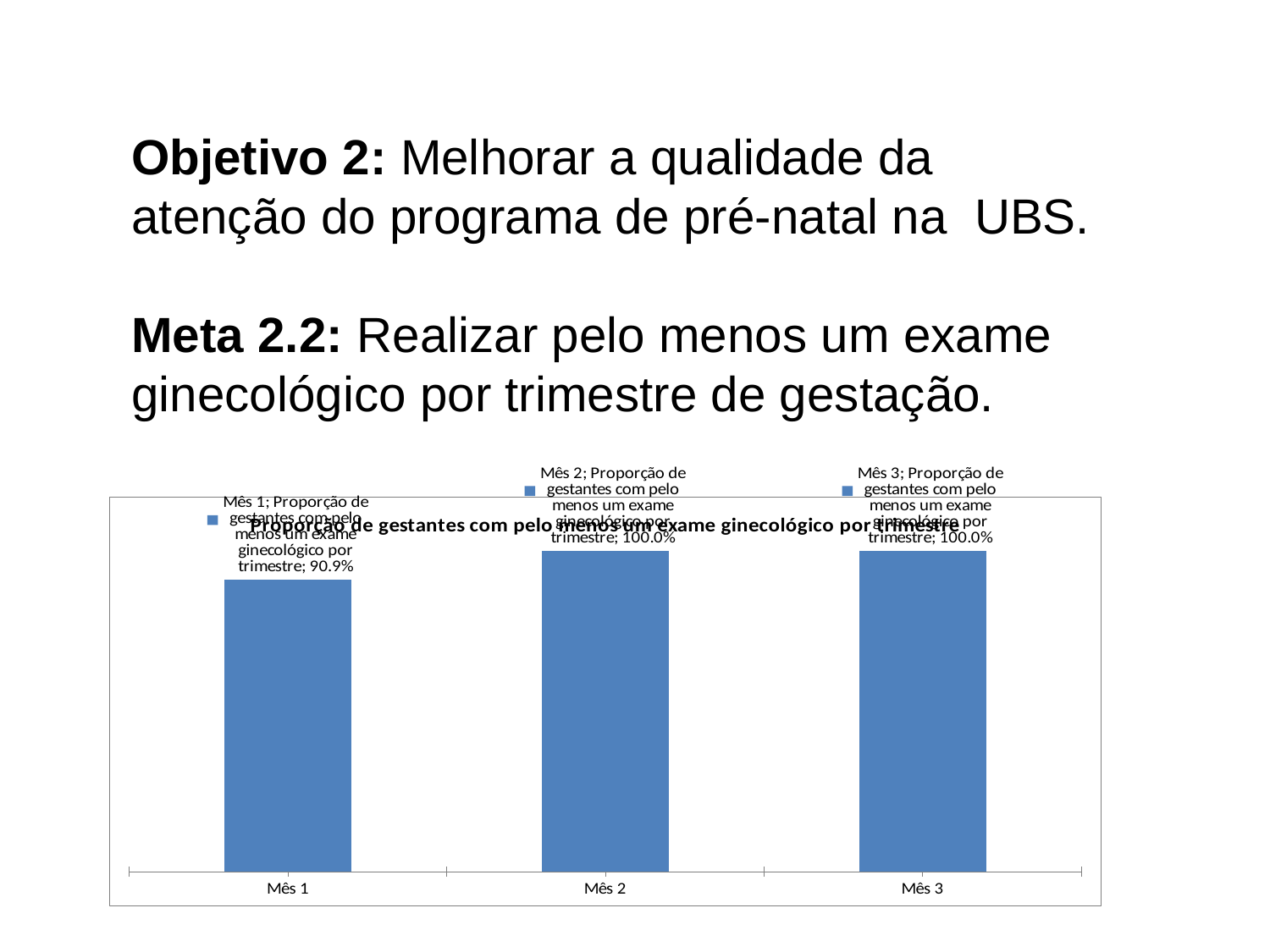
What colour are the bars in the chart? Blue How many months are shown on the x axis? 3 What is the difference between the values for Mês 2 and Mês 1? 9.1% What is the value for Mês 2? 100.0% Which month has the lowest value? Mês 1 What is the title of the chart? Proporção de gestantes com pelo menos um exame ginecológico por trimestre What kind of chart is shown on the slide? Bar chart What is the value for Mês 1? 90.9% Which is larger, the value for Mês 1 or the value for Mês 3? Mês 3 Does the value rise or fall from Mês 1 to Mês 2? Rise What is the value for Mês 3? 100.0%